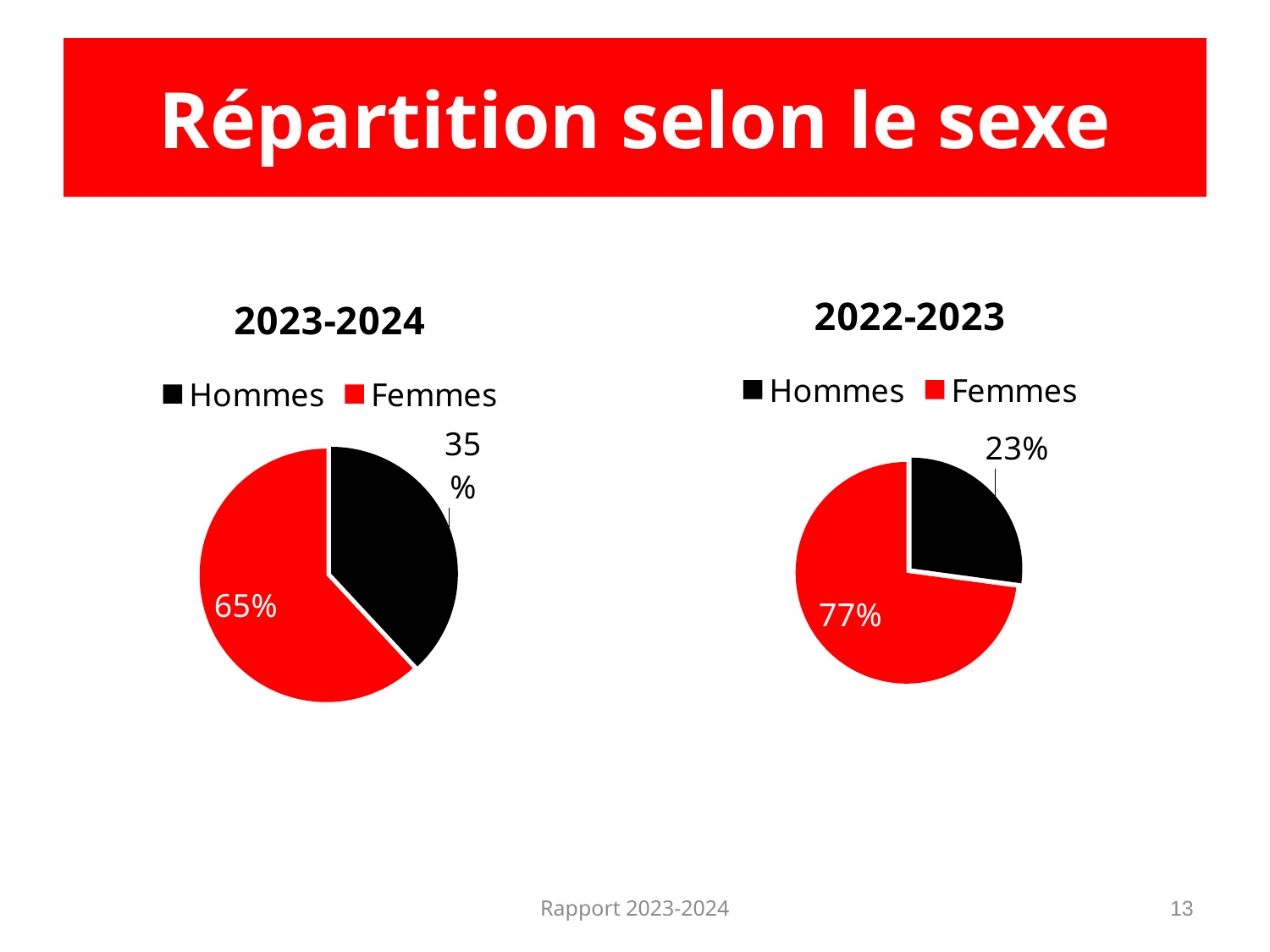
In the 2023-2024 chart, what share of the pie is Hommes? 35% Is the Hommes share larger in the 2023-2024 chart or the 2022-2023 chart? 2023-2024 In the 2022-2023 chart, what share of the pie is Femmes? 77% In the 2023-2024 chart, what share of the pie is Femmes? 65% In the 2023-2024 chart, which colour represents Femmes? Red In the 2022-2023 chart, what is the difference between the Femmes and Hommes shares? 54% What kind of chart is the 2023-2024 chart? Pie chart In the 2022-2023 chart, which category has the smallest slice? Hommes In the 2023-2024 chart, which category has the largest slice? Femmes How many categories does the 2022-2023 chart show? 2 In the 2023-2024 chart, what is the difference between the Femmes and Hommes shares? 30%